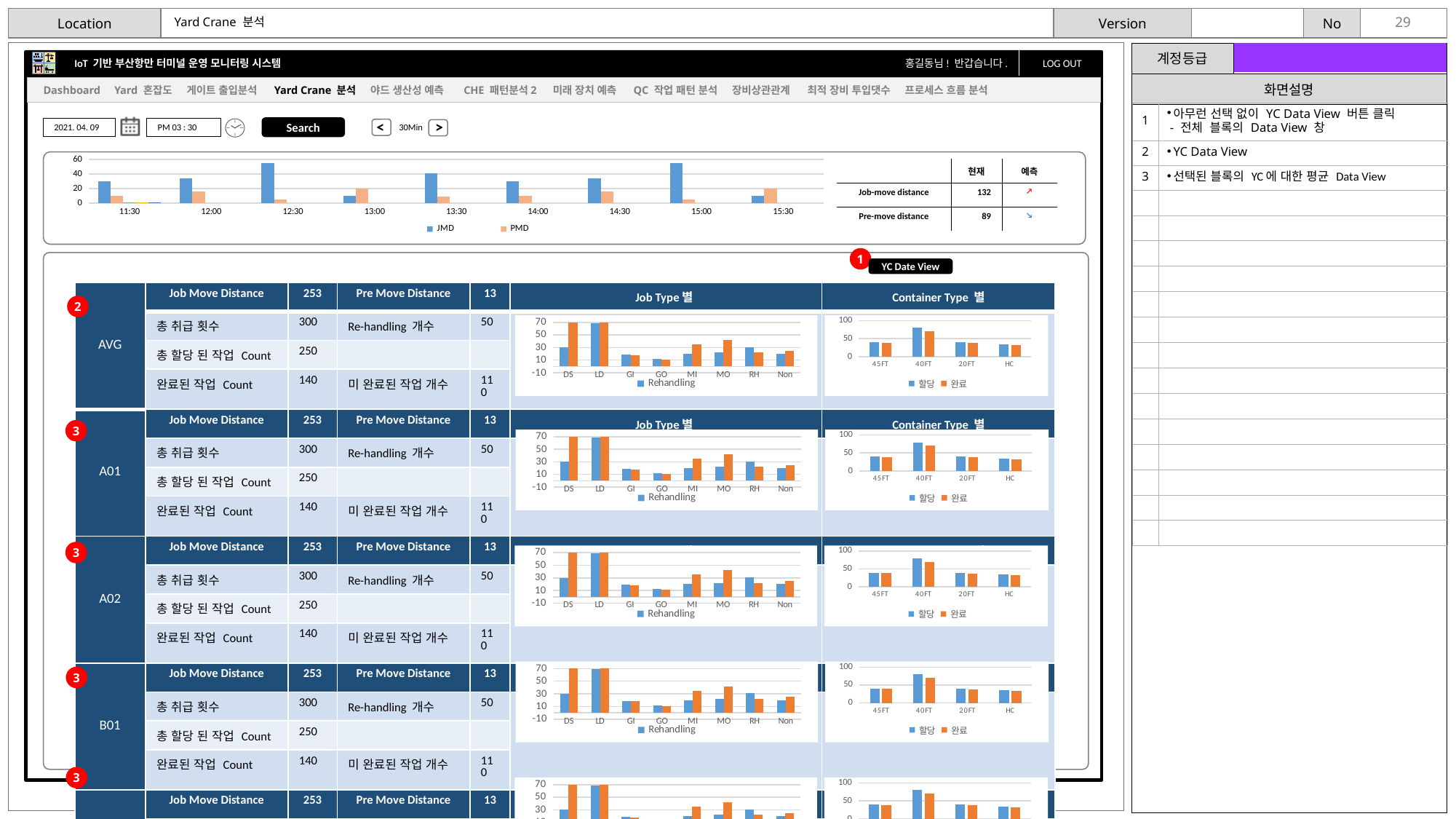
In the 'Job Type 별' chart for the AVG row, which category has the lowest values? GO In the 'Container Type 별' chart for the AVG row, which container type has the highest 할당 value? 40FT In the 'Job Type 별' chart for the AVG row, how many job type categories are shown on the x axis? 8 In the top JMD/PMD chart, at 12:30, which series has the larger value, JMD or PMD? JMD In the top JMD/PMD chart, at 13:00, which series has the larger value, JMD or PMD? PMD In the top JMD/PMD chart, is the JMD value at 12:30 greater or less than 40? greater In the top JMD/PMD chart, is the JMD value at 13:00 greater or less than 20? less In the top JMD/PMD chart, how many series does the legend list? 2 What kind of chart is the chart at the top of the slide showing JMD and PMD over time? bar chart In the top JMD/PMD chart, how many time points are shown on the x axis? 9 In the 'Container Type 별' chart for the AVG row, how many series does the legend list? 2 In the 'Container Type 별' chart for the AVG row, is the 할당 value for 40FT greater or less than 50? greater